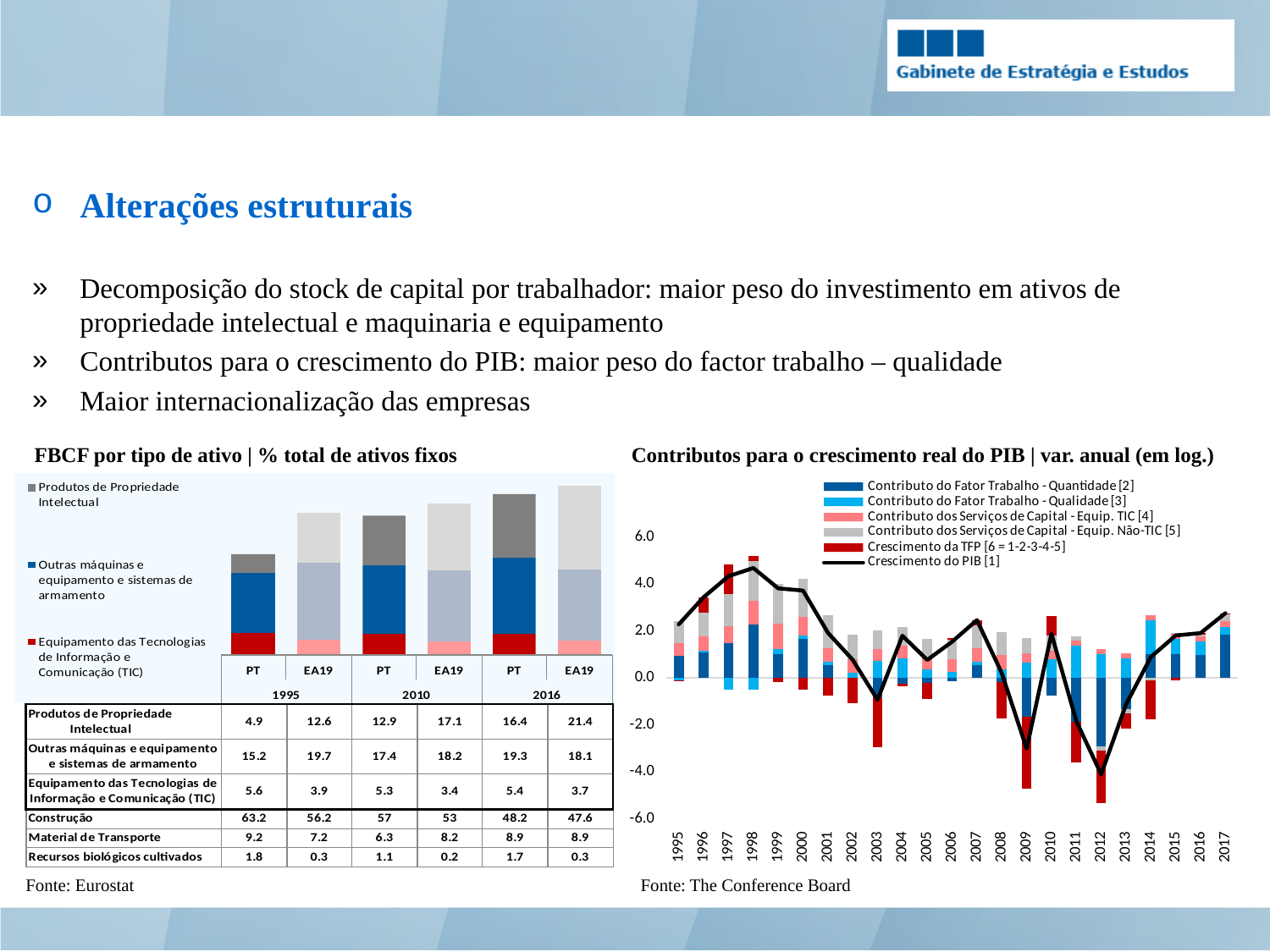
In the chart 'FBCF por tipo de ativo', what is the difference between the Produtos de Propriedade Intelectual values for EA19 and PT in 1995? 7.7 What kind of chart is 'Contributos para o crescimento real do PIB'? Stacked bar chart with a line In the chart 'FBCF por tipo de ativo', how does the Produtos de Propriedade Intelectual value for PT change from 1995 to 2016? It rises In the chart 'FBCF por tipo de ativo', which bar has the highest value for Produtos de Propriedade Intelectual? EA19 2016 In the chart 'Contributos para o crescimento real do PIB', is the Crescimento do PIB value for 2012 greater or less than -2.0? less In the chart 'FBCF por tipo de ativo', what is the value of Equipamento das Tecnologias de Informação e Comunicação (TIC) for EA19 in 2010? 3.4 In the chart 'FBCF por tipo de ativo', what is the value of Produtos de Propriedade Intelectual for PT in 2016? 16.4 In the chart 'FBCF por tipo de ativo', how many series does the legend list? 3 In the chart 'FBCF por tipo de ativo', what is the value of Outras máquinas e equipamento e sistemas de armamento for EA19 in 1995? 19.7 In the chart 'Contributos para o crescimento real do PIB', how many entries does the legend list? 6 In the chart 'Contributos para o crescimento real do PIB', how many years are shown on the x axis? 23 In the chart 'FBCF por tipo de ativo', which is larger in 2016: Equipamento TIC for PT or for EA19? PT